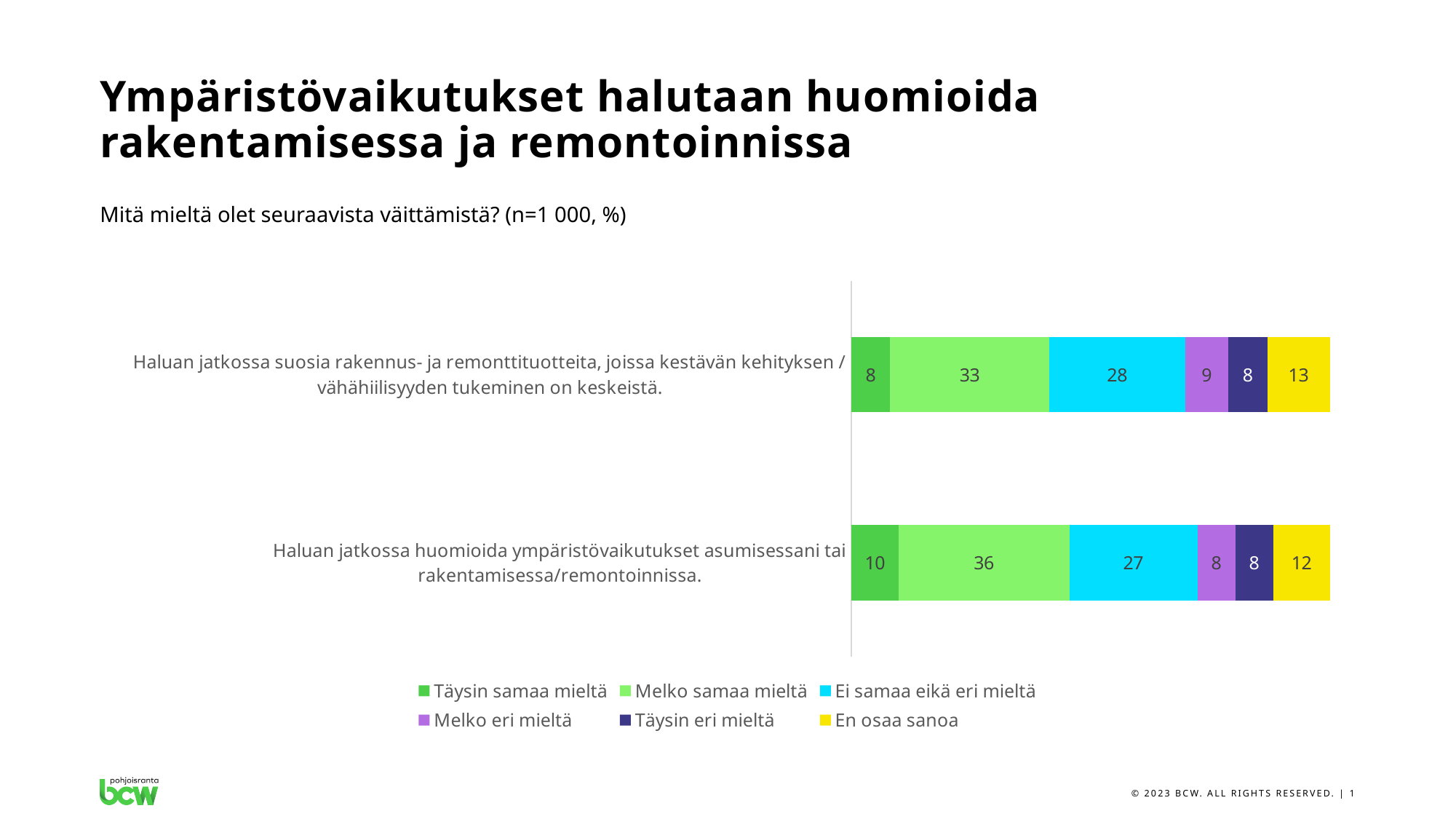
What is the value for "En osaa sanoa" in the bar "Haluan jatkossa suosia rakennus- ja remonttituotteita, joissa kestävän kehityksen / vähähiilisyyden tukeminen on keskeistä."? 13 What is the value for "Ei samaa eikä eri mieltä" in the bar "Haluan jatkossa suosia rakennus- ja remonttituotteita, joissa kestävän kehityksen / vähähiilisyyden tukeminen on keskeistä."? 28 Which series has the largest value in the bar "Haluan jatkossa huomioida ympäristövaikutukset asumisessani tai rakentamisessa/remontoinnissa."? Melko samaa mieltä What kind of chart is shown on the slide? Stacked bar chart How many series does the legend list? 6 Which series has the largest value in the bar "Haluan jatkossa suosia rakennus- ja remonttituotteita, joissa kestävän kehityksen / vähähiilisyyden tukeminen on keskeistä."? Melko samaa mieltä Which bar has the larger "Täysin samaa mieltä" value? Haluan jatkossa huomioida ympäristövaikutukset asumisessani tai rakentamisessa/remontoinnissa. What is the value for "Melko samaa mieltä" in the bar "Haluan jatkossa huomioida ympäristövaikutukset asumisessani tai rakentamisessa/remontoinnissa."? 36 What is the difference between the "Melko samaa mieltä" values of the two bars? 3 How many bars (statements) does the chart show? 2 What is the value for "Täysin samaa mieltä" in the bar "Haluan jatkossa huomioida ympäristövaikutukset asumisessani tai rakentamisessa/remontoinnissa."? 10 What is the total of the bar "Haluan jatkossa huomioida ympäristövaikutukset asumisessani tai rakentamisessa/remontoinnissa."? 101